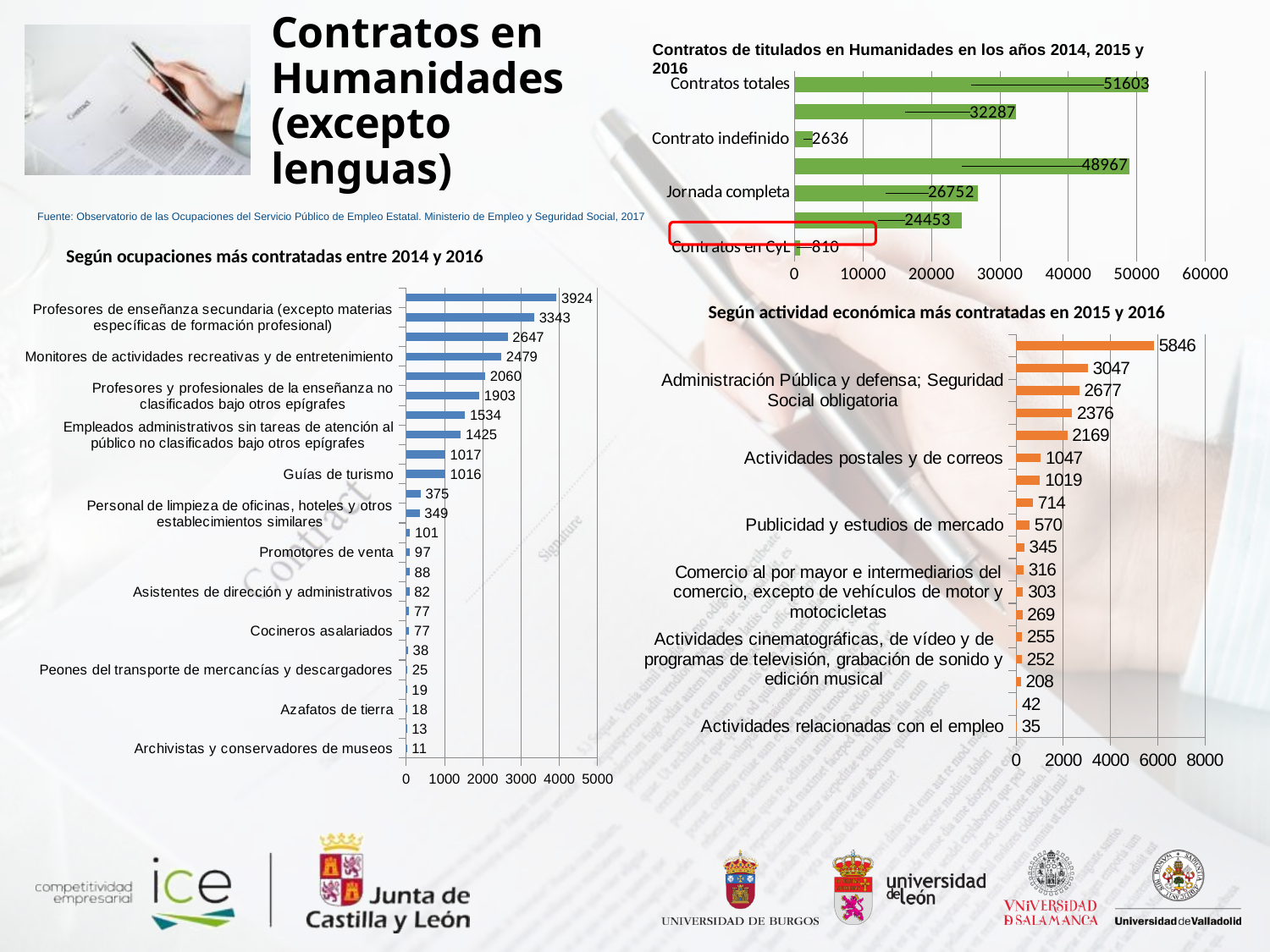
In the chart 'Según actividad económica más contratadas en 2015 y 2016', what is the highest value shown? 5846 In the chart 'Contratos de titulados en Humanidades en los años 2014, 2015 y 2016', what is the value for Contratos en CyL? 810 In the chart 'Según ocupaciones más contratadas entre 2014 y 2016', what is the difference between the values for Guías de turismo and Personal de limpieza de oficinas, hoteles y otros establecimientos similares? 667 In the chart 'Contratos de titulados en Humanidades en los años 2014, 2015 y 2016', what is the largest value shown? 51603 In the chart 'Según ocupaciones más contratadas entre 2014 y 2016', which is larger: Promotores de venta or Cocineros asalariados? Promotores de venta In the chart 'Según actividad económica más contratadas en 2015 y 2016', what is the value for Actividades relacionadas con el empleo? 35 In the chart 'Según ocupaciones más contratadas entre 2014 y 2016', what is the value for Archivistas y conservadores de museos? 11 In the chart 'Según actividad económica más contratadas en 2015 y 2016', what is the value for Actividades postales y de correos? 1047 What kind of chart is 'Contratos de titulados en Humanidades en los años 2014, 2015 y 2016'? Bar chart In the chart 'Según ocupaciones más contratadas entre 2014 y 2016', what is the value for Guías de turismo? 1016 In the chart 'Según actividad económica más contratadas en 2015 y 2016', what is the difference between the values for Actividades postales y de correos and Publicidad y estudios de mercado? 477